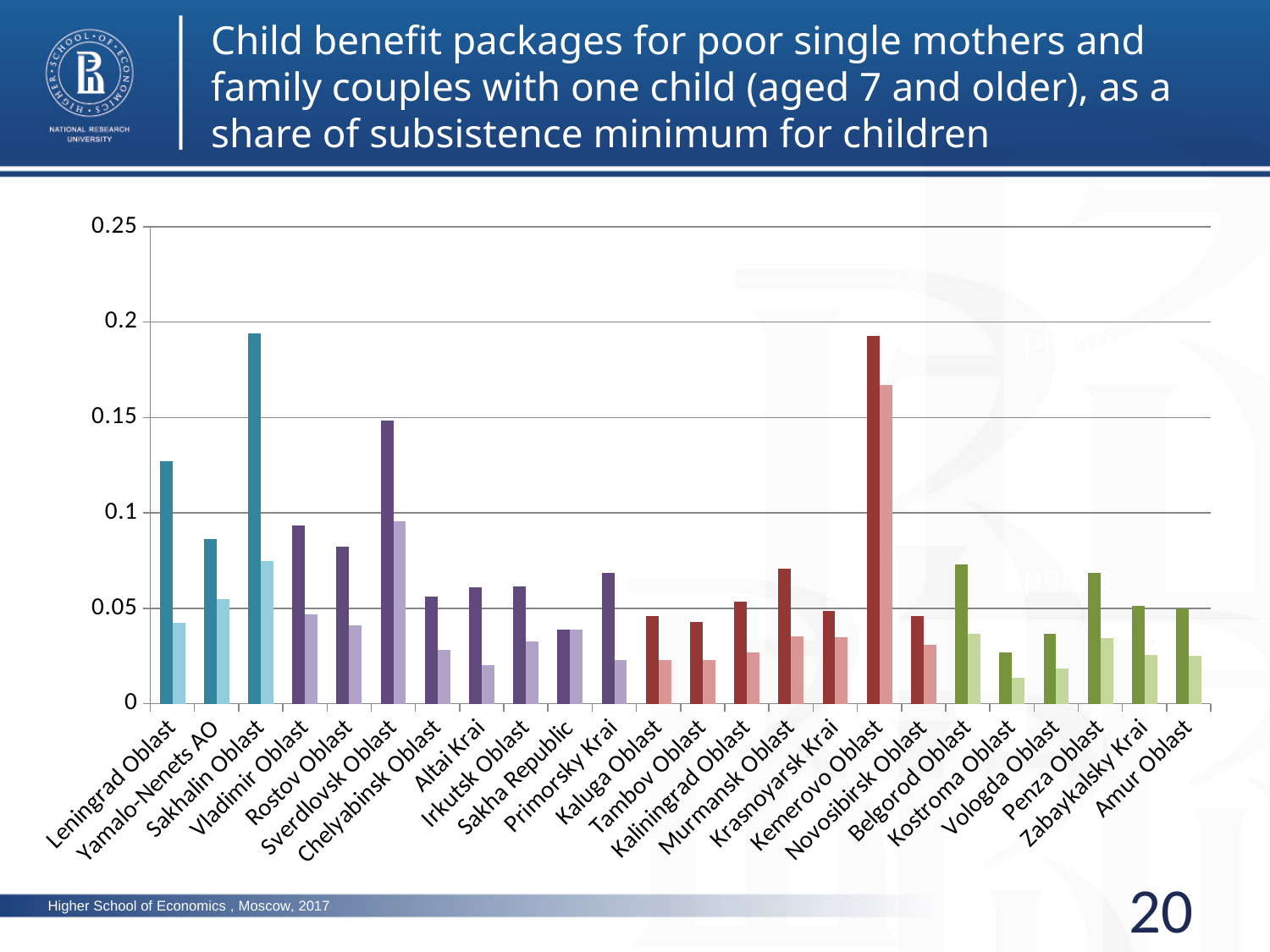
Which has the larger dark bar, Sverdlovsk Oblast or Rostov Oblast? Sverdlovsk Oblast Is the value of the taller (dark) bar for Kostroma Oblast greater or less than 0.05? less Which region has the lowest dark bar in the chart? Kostroma Oblast Is the value of the taller (dark) bar for Sakhalin Oblast greater or less than 0.15? greater How many regions are listed along the x axis of the chart? 24 Is the value of the taller (dark) bar for Sverdlovsk Oblast greater or less than 0.1? greater What kind of chart is shown on the slide? bar chart Which has the larger dark bar, Leningrad Oblast or Yamalo-Nenets AO? Leningrad Oblast How many bars are plotted for each region in the chart? 2